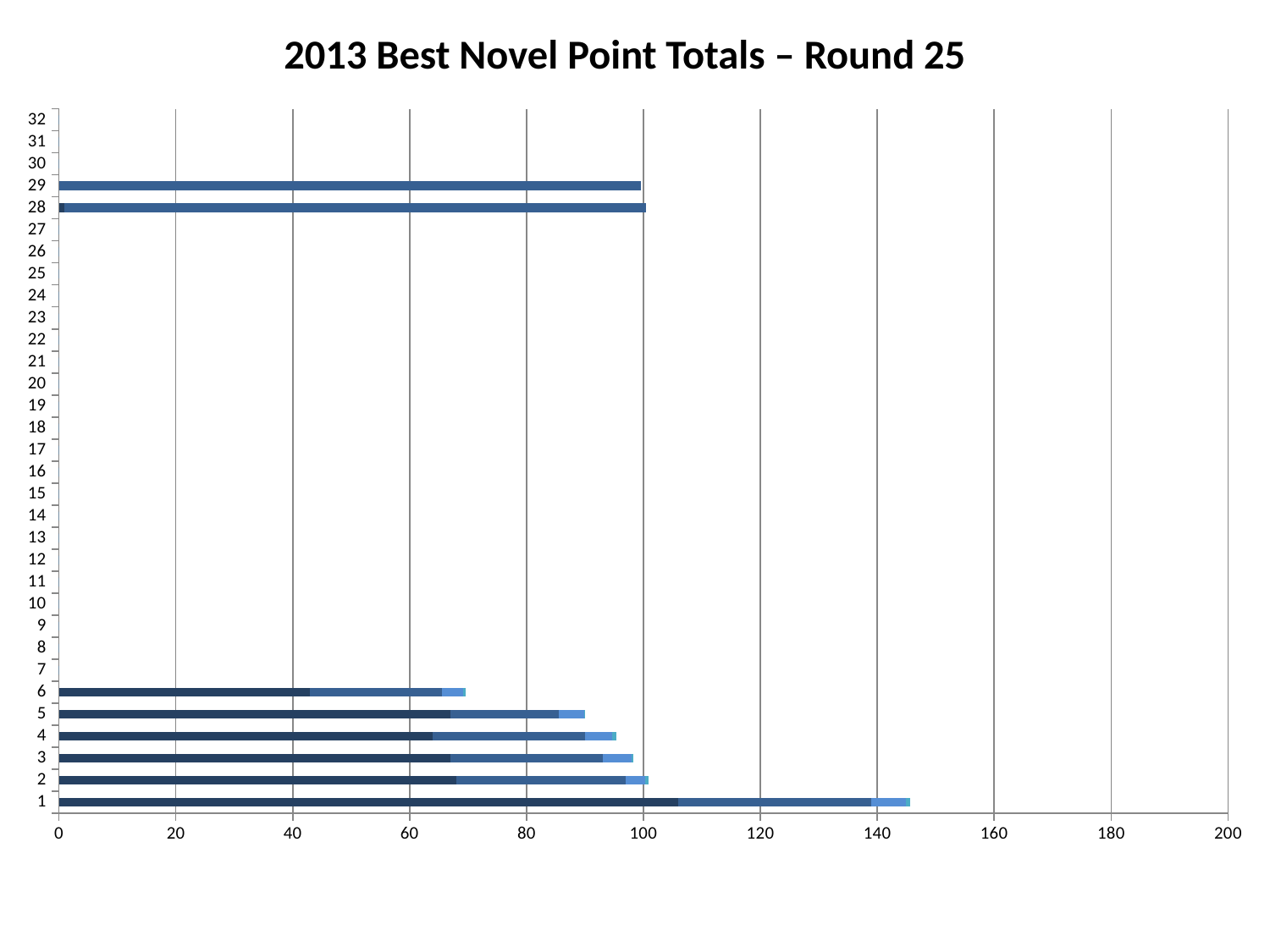
Among the categories that have a bar, which has the shortest bar? 6 Which has the larger total, category 4 or category 6? 4 Is the value for category 28 greater or less than 120? less Is the total value for category 6 greater or less than 80? less Is the total value for category 4 greater or less than 80? greater How many categories are listed on the vertical axis? 32 How many categories have a visible bar? 8 What kind of chart is shown on the slide? bar chart What is the title of the chart? 2013 Best Novel Point Totals – Round 25 Which category has the longest bar? 1